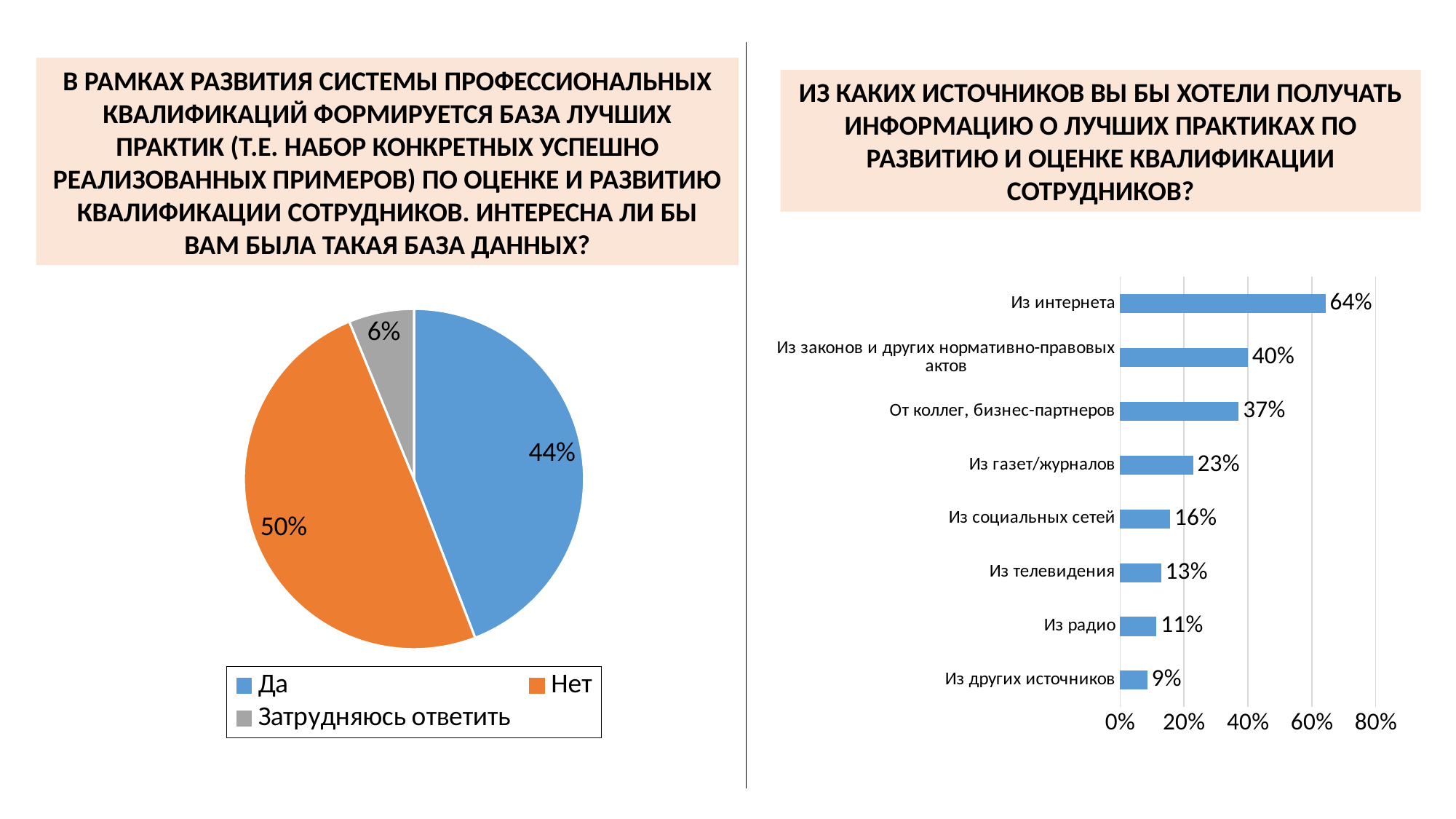
In the pie chart on the left, how many entries does the legend list? 3 In the pie chart on the left, what share of respondents answered "Нет"? 50% In the bar chart on the right, what is the value for "Из газет/журналов"? 23% In the bar chart on the right, what is the value for "Из интернета"? 64% In the pie chart on the left, what share of respondents answered "Да"? 44% In the bar chart on the right, which is larger: "Из социальных сетей" or "Из телевидения"? Из социальных сетей In the pie chart on the left, what is the difference between the "Нет" and "Да" shares? 6% In the bar chart on the right, which source has the lowest value? Из других источников In the bar chart on the right, how many categories are shown? 8 What kind of chart is on the right side of the slide? Bar chart In the bar chart on the right, what is the difference between "Из интернета" and "Из законов и других нормативно-правовых актов"? 24% In the pie chart on the left, which answer has the smallest slice? Затрудняюсь ответить